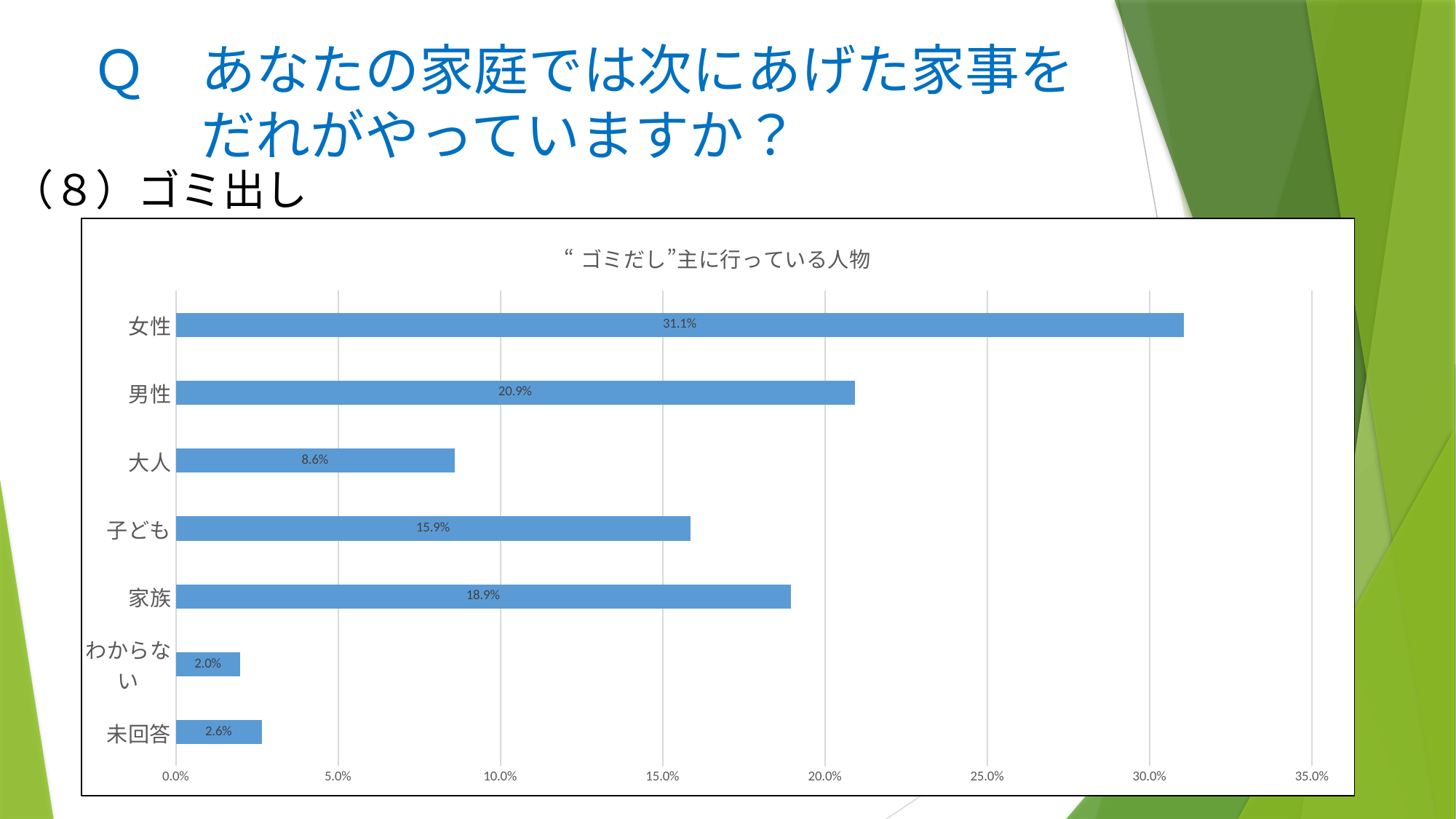
What percentage is shown for 家族? 18.9% Which is larger, the value for 家族 or the value for 子ども? 家族 What is the difference between the values for 女性 and 男性? 10.2% What value is labelled on the bar for 子ども? 15.9% What kind of chart is shown on the slide? bar chart What is the value for 男性? 20.9% Which category has the highest value? 女性 Which category has the lowest value? わからない What is the title of the chart? “ゴミだし”主に行っている人物 Is the value for 大人 greater or less than 10.0%? less What percentage is shown for 女性 in the chart? 31.1% How many categories are plotted in the chart? 7